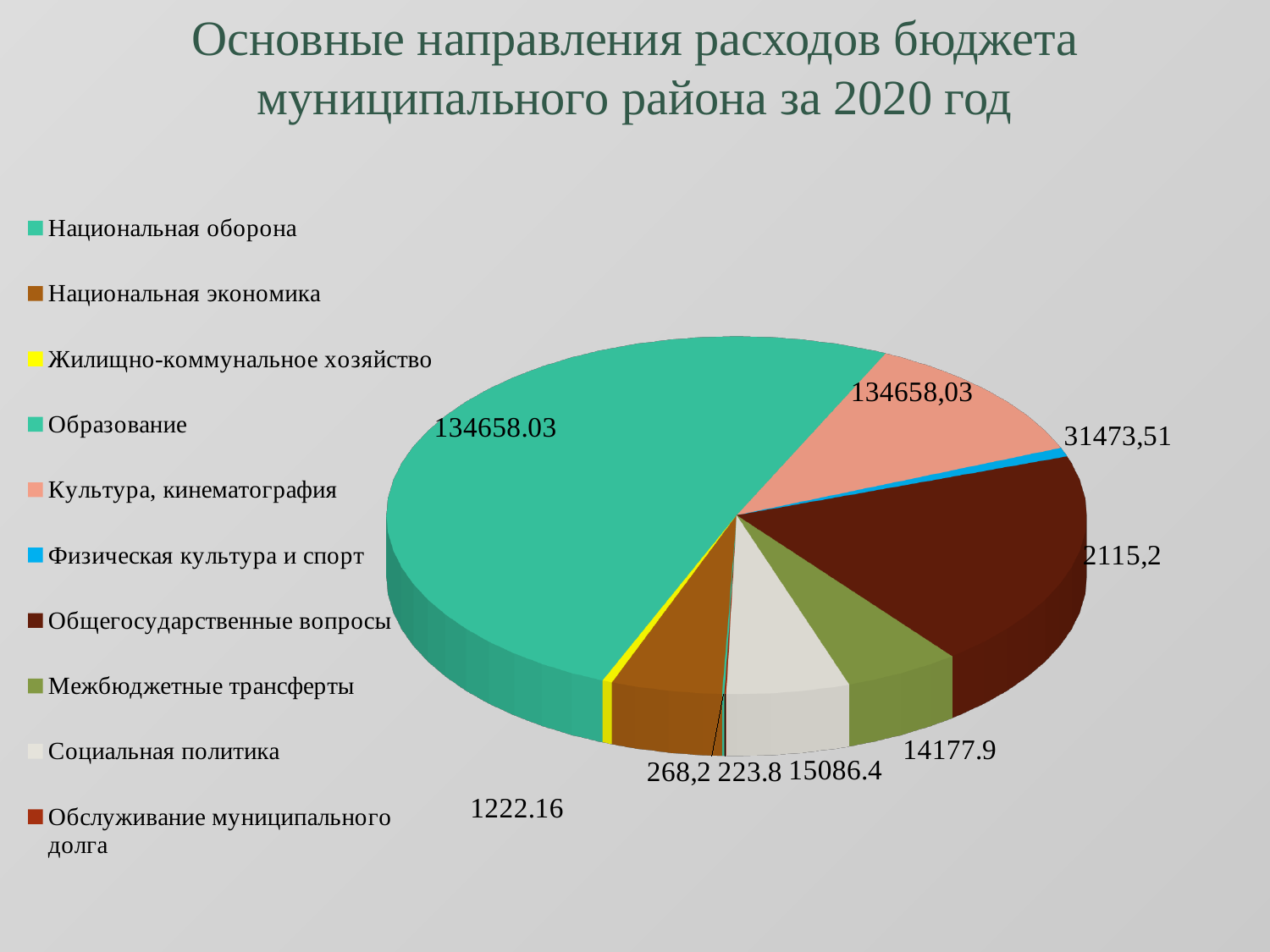
What is the title of the chart on the slide? Основные направления расходов бюджета муниципального района за 2020 год Which category is listed last in the legend? Обслуживание муниципального долга What value is printed for the Социальная политика slice (light grey)? 15086.4 What colour is the legend marker for Жилищно-коммунальное хозяйство? yellow How many categories does the legend of the pie chart list? 10 What kind of chart is shown on the slide? pie chart What is the difference between the values printed for Социальная политика (15086.4) and Межбюджетные трансферты (14177.9)? 908.5 What value is printed on the largest slice of the pie chart? 134658.03 Which is larger, the value for Социальная политика or the value for Межбюджетные трансферты? Социальная политика What value is printed for the Межбюджетные трансферты slice (olive green)? 14177.9 Which category is listed first in the legend? Национальная оборона